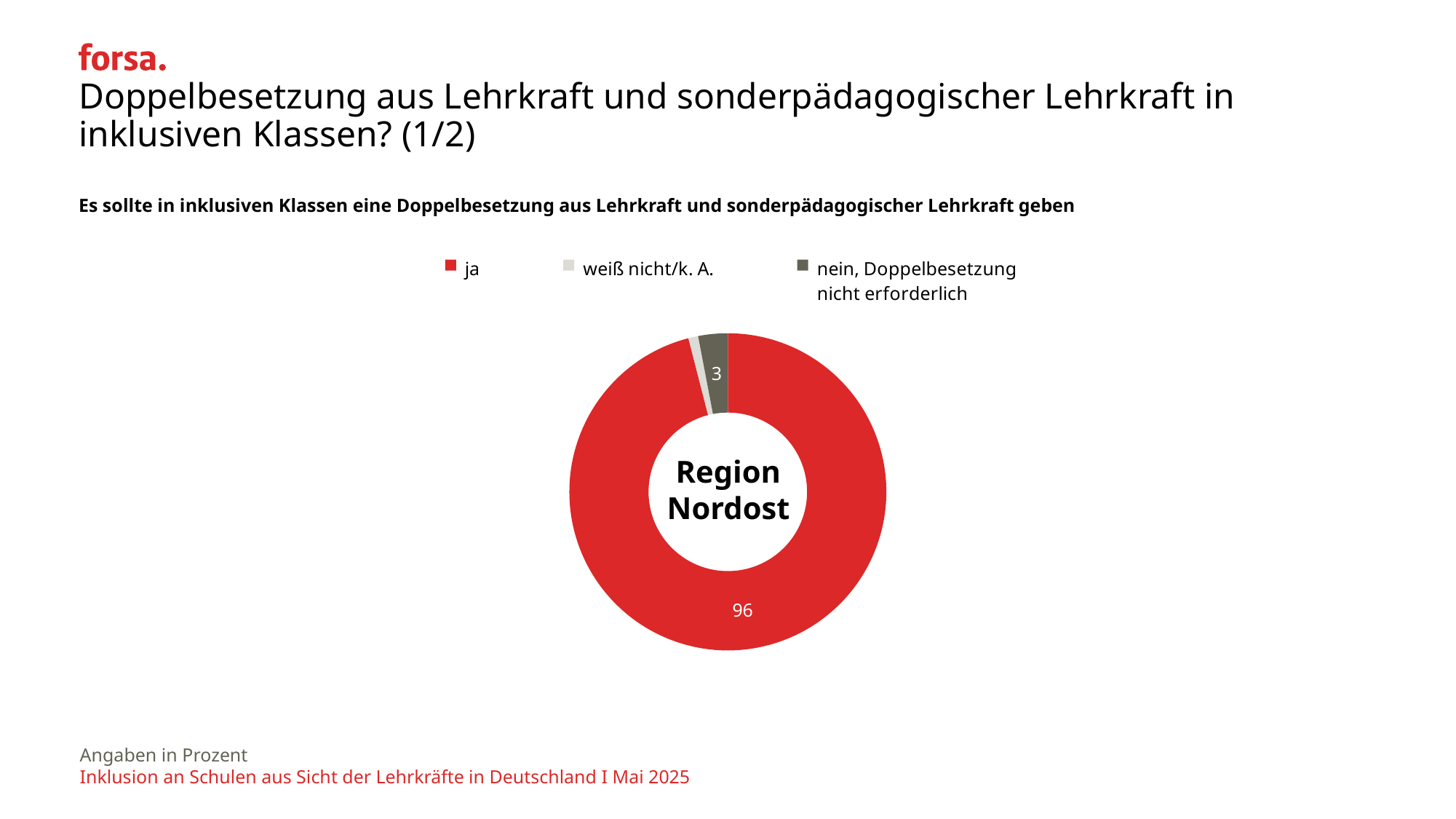
What is the value for "ja" in the pie chart? 96 What share of the pie does the "ja" slice represent? 96% What colour is the "ja" slice in the pie chart? red Which category has the largest slice in the pie chart? ja What kind of chart is shown on the slide? doughnut chart What label is shown in the centre of the pie chart? Region Nordost What is the difference between the values for "ja" and "nein, Doppelbesetzung nicht erforderlich"? 93 Which category has the smallest slice in the pie chart? weiß nicht/k. A. How many entries does the legend list? 3 How many slices does the pie chart have? 3 Which is larger, the value for "ja" or the value for "nein, Doppelbesetzung nicht erforderlich"? ja What is the value for "nein, Doppelbesetzung nicht erforderlich" in the pie chart? 3